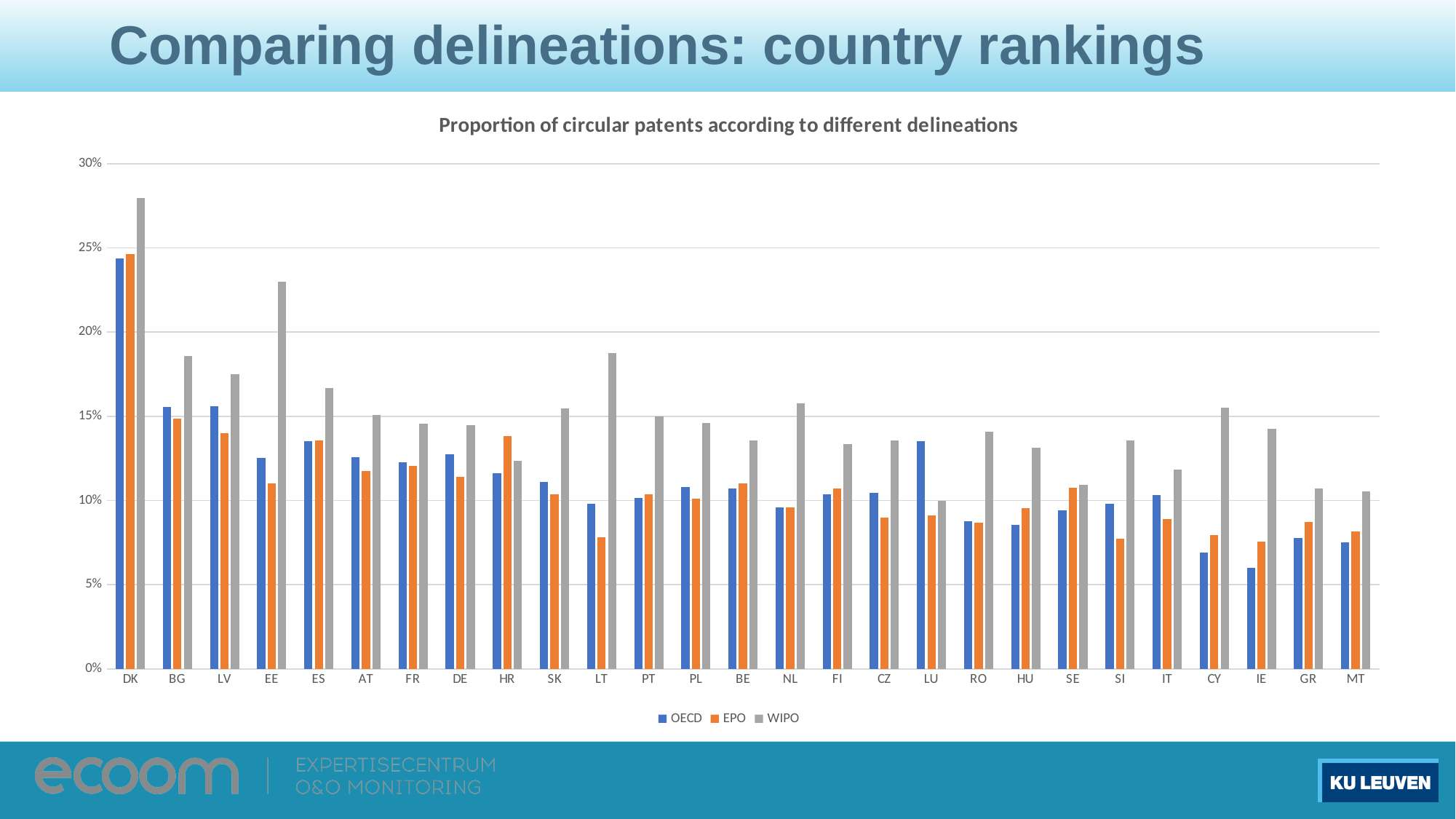
Is the WIPO value for EE greater or less than 20%? greater Is the WIPO value for DK greater or less than 25%? greater For LU, which is larger: the OECD value or the EPO value? OECD Which country has the highest WIPO value? DK What kind of chart is shown on the slide? bar chart How many countries are shown on the x axis? 27 Which country has the lowest OECD value? IE How many series does the legend list? 3 Is the OECD value for IE greater or less than 5%? greater For HR, which is larger: the OECD value or the EPO value? EPO Do the OECD values generally rise or fall from left to right along the x axis? fall Which country has the highest OECD value? DK